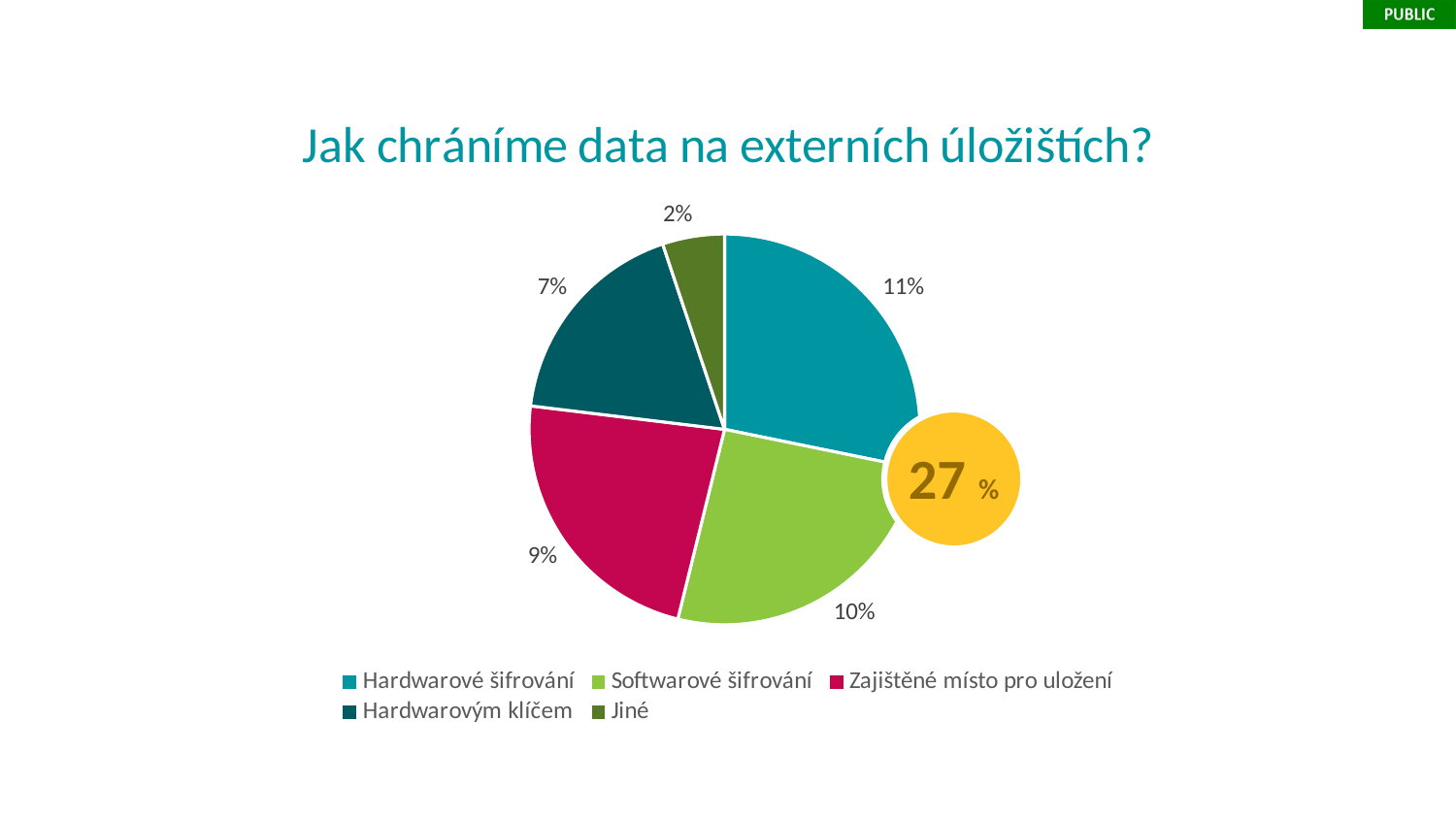
What type of chart is shown on the slide? pie chart What value is shown for Softwarové šifrování? 10% What value is shown for Hardwarovým klíčem? 7% What is the title of the chart? Jak chráníme data na externích úložištích? Which category has the smallest slice of the pie? Jiné Which category has the largest slice of the pie? Hardwarové šifrování What value is shown for Hardwarové šifrování? 11% What is the difference between the values for Hardwarové šifrování and Hardwarovým klíčem? 4% How many categories does the legend list? 5 What value is shown for Zajištěné místo pro uložení? 9% Which is larger, the value for Zajištěné místo pro uložení or the value for Jiné? Zajištěné místo pro uložení What value is shown for Jiné? 2%